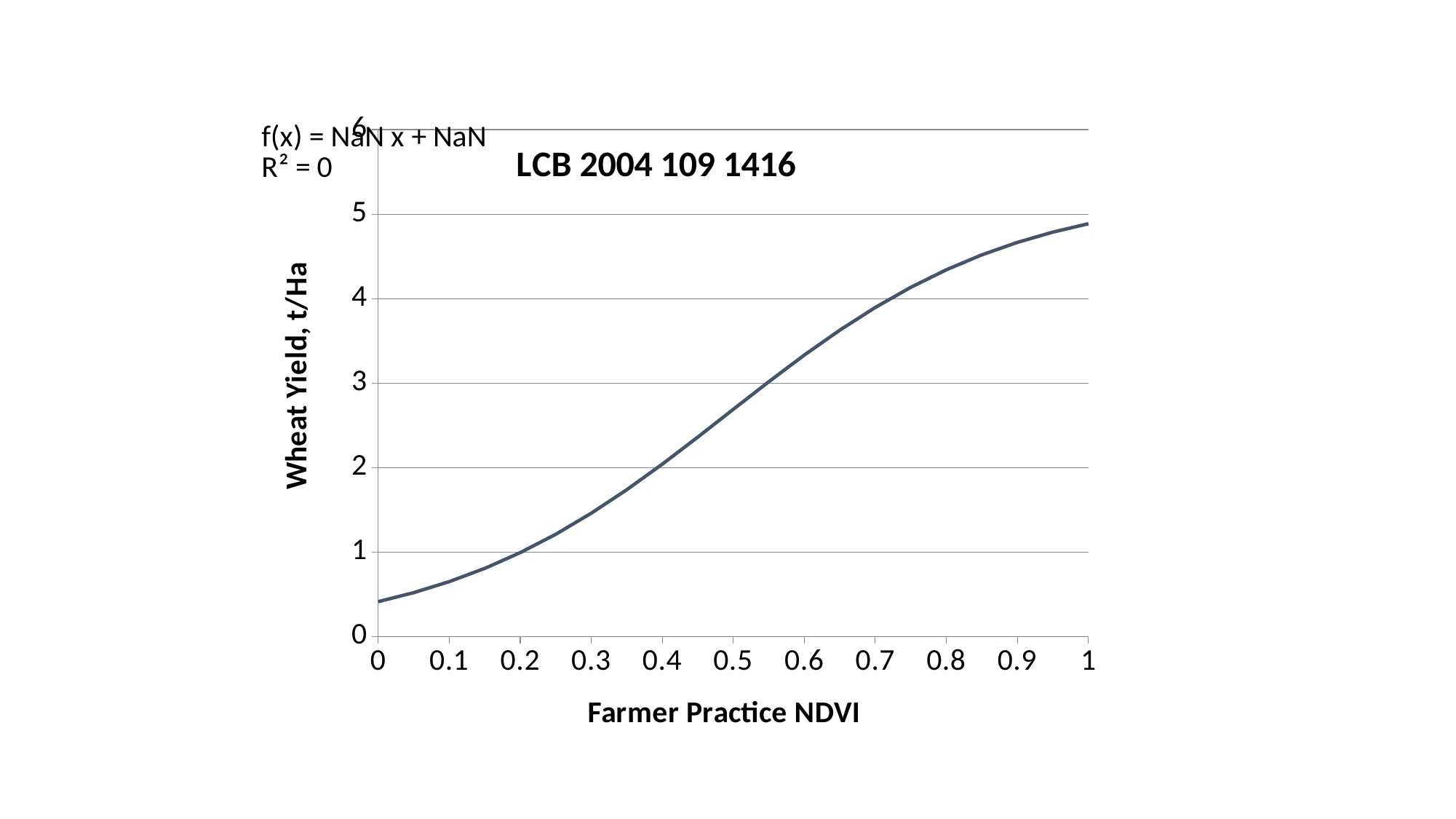
Does wheat yield rise or fall as Farmer Practice NDVI increases from 0 to 1? rise Is the wheat yield at Farmer Practice NDVI 0 greater or less than 1? less Is the wheat yield at Farmer Practice NDVI 0.3 greater or less than 1? greater What is the title of the chart? LCB 2004 109 1416 What kind of chart is shown on the slide? line chart Is the wheat yield at Farmer Practice NDVI 1 greater or less than 4? greater What is the label of the y axis? Wheat Yield, t/Ha At which Farmer Practice NDVI value shown on the x axis is wheat yield highest? 1 At which Farmer Practice NDVI value shown on the x axis is wheat yield lowest? 0 Which has the higher wheat yield: Farmer Practice NDVI 0.2 or 0.8? 0.8